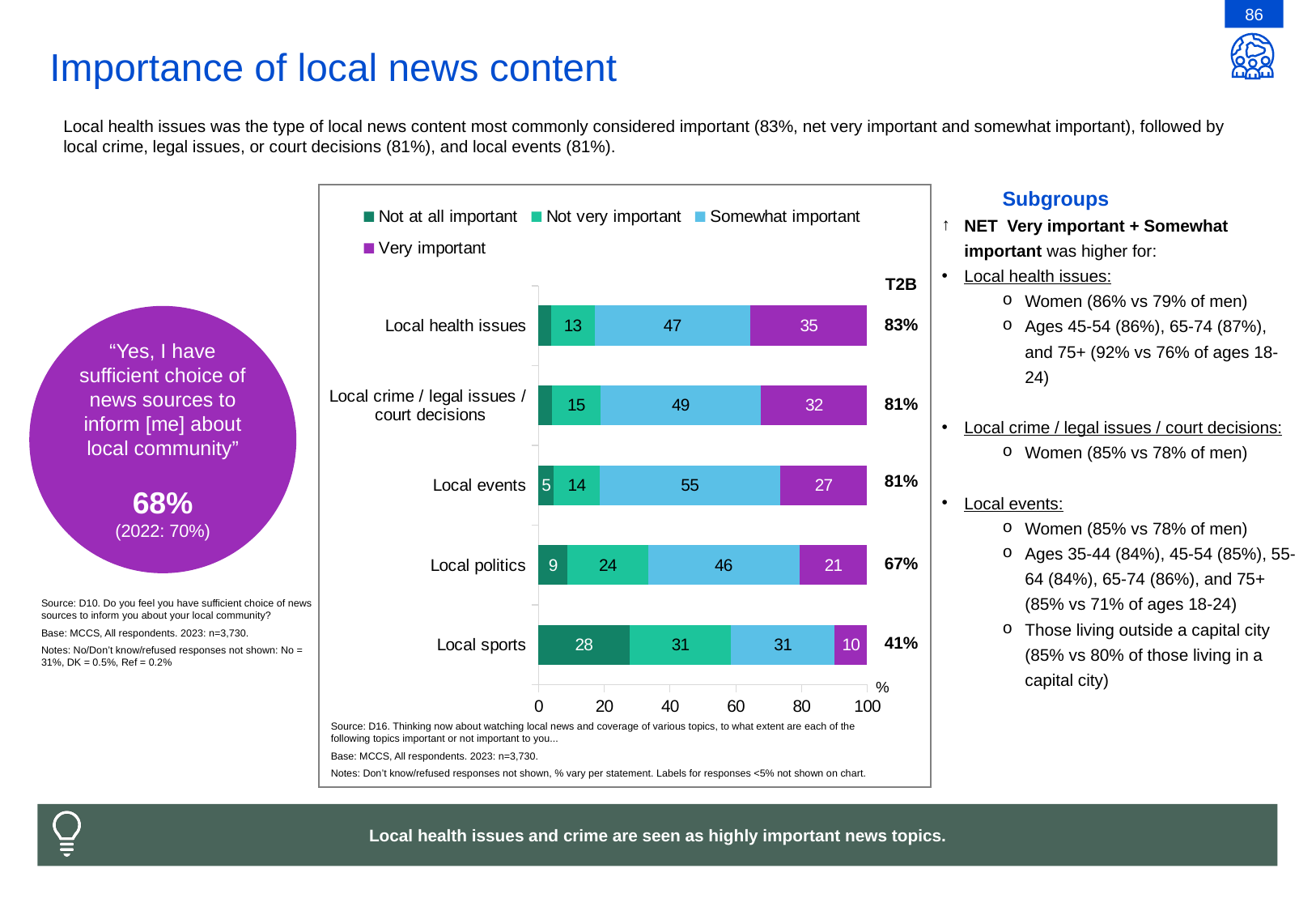
What is the Not at all important value for Local sports? 28 Which has a larger Not very important value, Local sports or Local health issues? Local sports How many categories of local news content are shown on the chart? 5 What is the difference between the Somewhat important values for Local events and Local politics? 9 What type of chart is used to show the importance of local news content? Stacked bar chart What is the T2B value shown for Local politics? 67% What is the Somewhat important value for Local events? 55 Which category has the lowest Very important value? Local sports How many series does the chart legend list? 4 What is the total of the labelled segments in the Local sports bar? 100 Which category has the highest Very important value? Local health issues What percentage of respondents rated Local health issues as Very important? 35